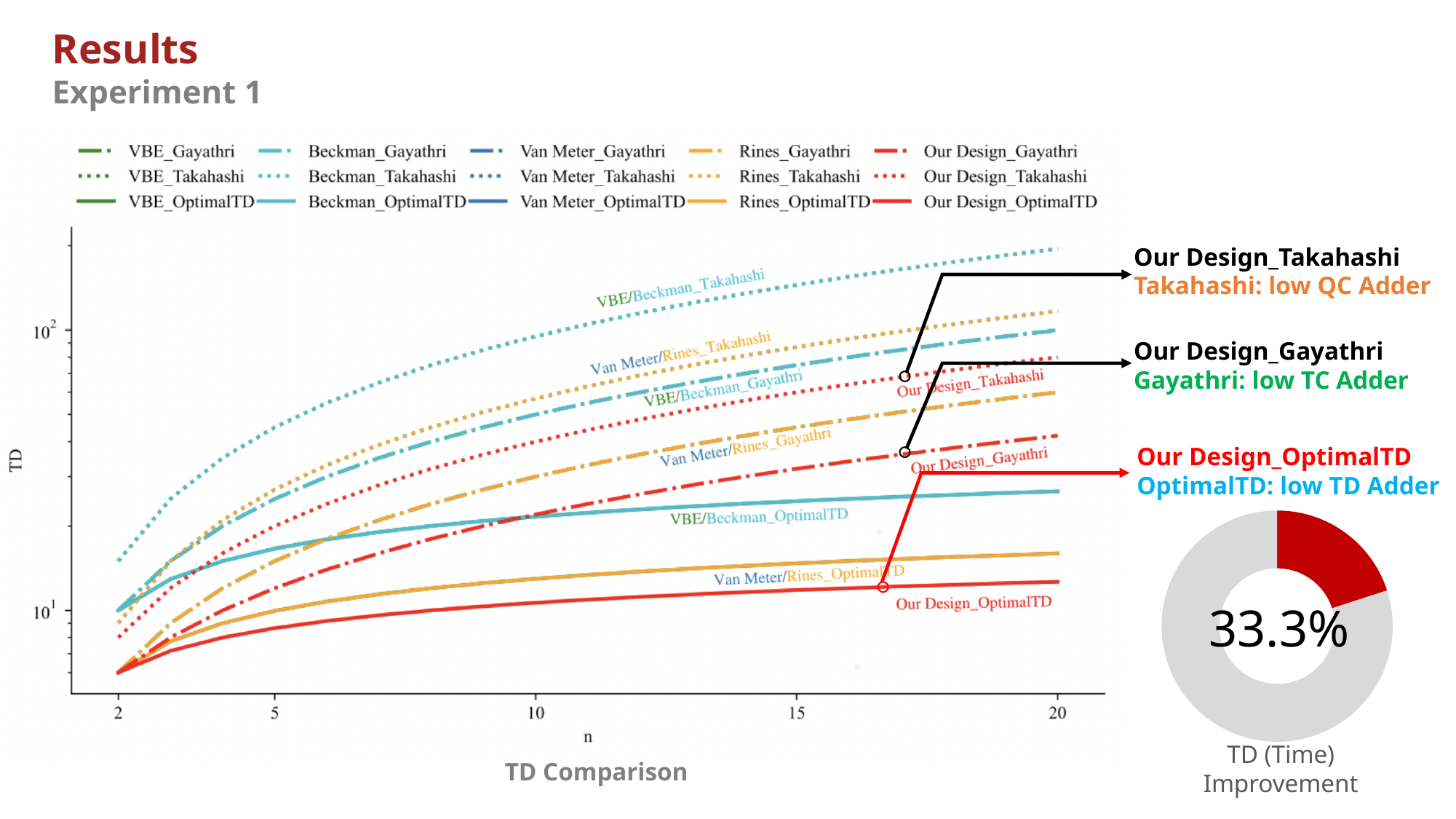
What percentage is shown in the 'TD (Time) Improvement' donut chart? 33.3% How many series does the legend of the 'TD Comparison' chart list? 15 What kind of chart is the 'TD Comparison' chart? line chart In the 'TD Comparison' chart, at n = 20, which is larger: Our Design_OptimalTD or Van Meter/Rines_OptimalTD? Van Meter/Rines_OptimalTD In the 'TD Comparison' chart, which curve is the highest at n = 20? VBE/Beckman_Takahashi In the 'TD Comparison' chart, at n = 20, which is larger: Our Design_Gayathri or VBE/Beckman_Gayathri? VBE/Beckman_Gayathri In the 'TD Comparison' chart, do the TD values rise or fall as n increases? rise What is the label of the x axis of the 'TD Comparison' chart? n In the 'TD Comparison' chart, is the value of VBE/Beckman_Takahashi at n = 20 greater or less than 10^2? greater In the 'TD Comparison' chart, which curve is the lowest at n = 20? Our Design_OptimalTD In the 'TD Comparison' chart, is the value of Our Design_OptimalTD at n = 20 greater or less than 10^1? greater In the 'TD Comparison' chart, is the value of Our Design_Takahashi at n = 20 greater or less than 10^2? less